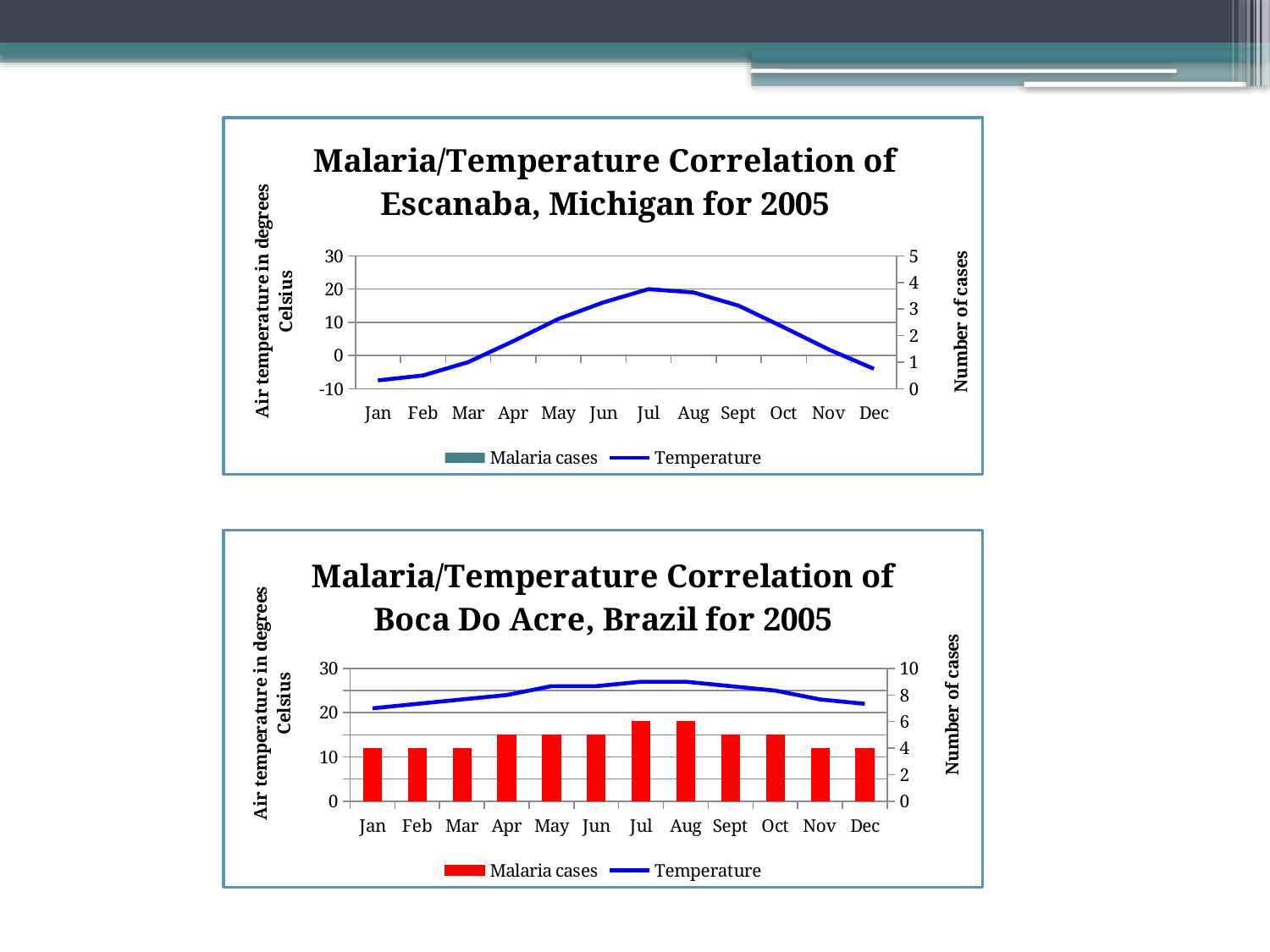
In the bottom chart (Boca Do Acre, Brazil), what colour are the malaria cases bars? red In the bottom chart (Boca Do Acre, Brazil), which months have the highest number of malaria cases? Jul and Aug In the bottom chart (Boca Do Acre, Brazil), how many malaria cases are shown for Jan? 4 How many months are shown on the x axis of the bottom chart (Boca Do Acre, Brazil)? 12 In the bottom chart (Boca Do Acre, Brazil), what is the difference in malaria cases between Jul and Jan? 2 In the bottom chart (Boca Do Acre, Brazil), what kind of chart is used to show the malaria cases? bar chart In the bottom chart (Boca Do Acre, Brazil), which has more malaria cases, Jul or Jan? Jul In the bottom chart (Boca Do Acre, Brazil), how many malaria cases are shown for Jul? 6 In the top chart (Escanaba, Michigan), is the temperature for Jan greater or less than 0? less In the top chart (Escanaba, Michigan), does the temperature rise or fall from Jan to Jul? rise How many series does the legend of the top chart (Escanaba, Michigan) list? 2 In the top chart (Escanaba, Michigan), is the temperature for Jul greater or less than 10? greater